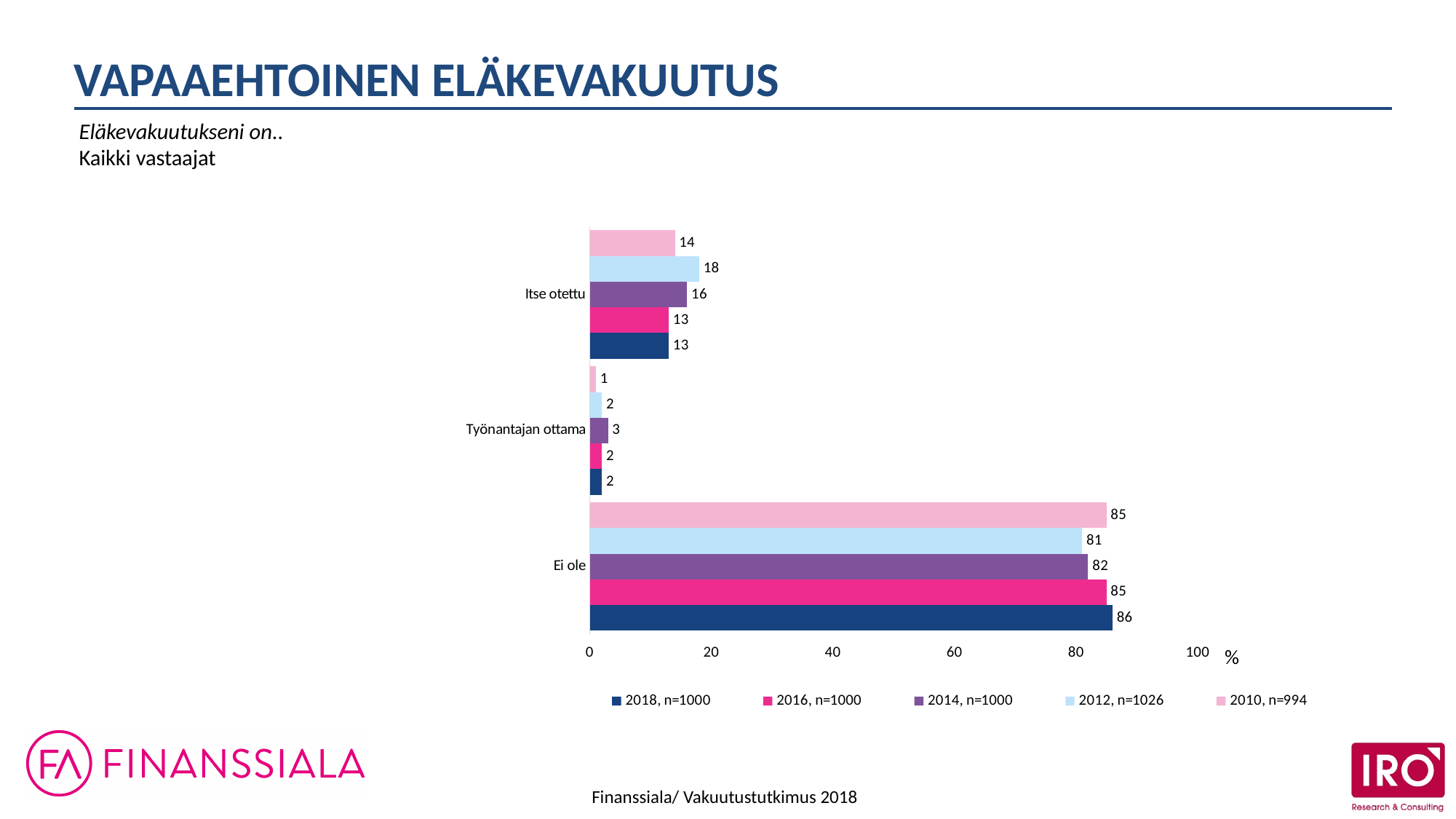
What is the value for "Itse otettu" in the 2010, n=994 series? 14 What is the value for "Työnantajan ottama" in the 2014, n=1000 series? 3 How many series does the legend list? 5 Is the value for "Ei ole" in the 2014, n=1000 series greater or less than 80? greater What is the value for "Ei ole" in the 2018, n=1000 series? 86 How many categories are shown on the y axis? 3 What is the value for "Itse otettu" in the 2012, n=1026 series? 18 What is the difference between the 2010, n=994 and 2018, n=1000 values for "Itse otettu"? 1 Which is larger for "Ei ole": the 2012, n=1026 value or the 2010, n=994 value? 2010, n=994 What kind of chart is shown on the slide? Bar chart Which category has the lowest value in the 2010, n=994 series? Työnantajan ottama Which category has the highest value in the 2016, n=1000 series? Ei ole